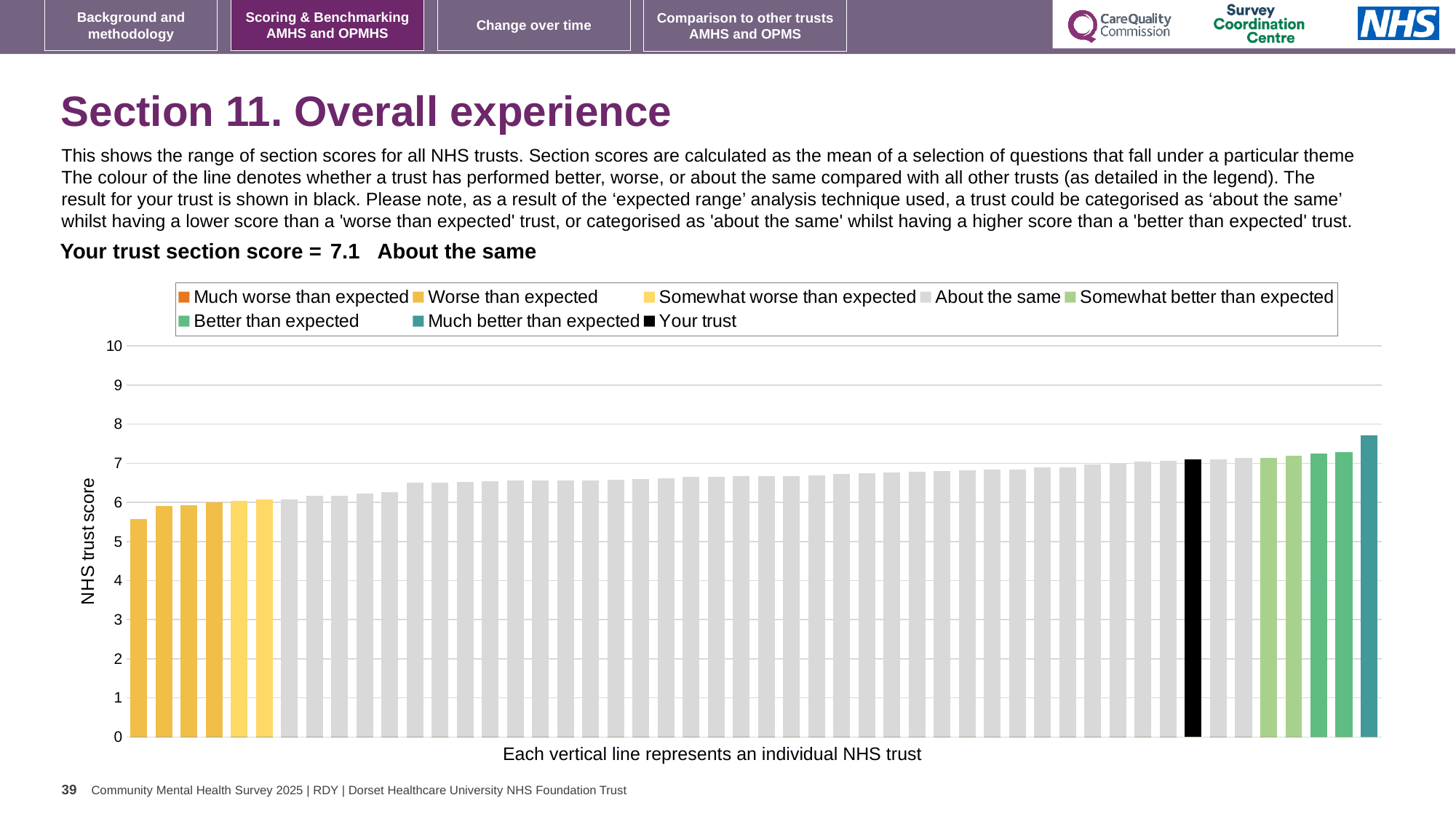
What kind of chart is shown on the slide? bar chart Which category is your trust's section score placed in? About the same Is the highest bar on the chart greater or less than 7? greater Is the value for your trust greater or less than 6? greater What is the label on the vertical axis of the chart? NHS trust score How many entries does the chart legend list? 8 How many bars are coloured as 'Much better than expected'? 1 What colour is the bar representing your trust? black Is the highest bar on the chart greater or less than 8? less Which legend category does the highest bar on the chart belong to? Much better than expected What is the section score for your trust? 7.1